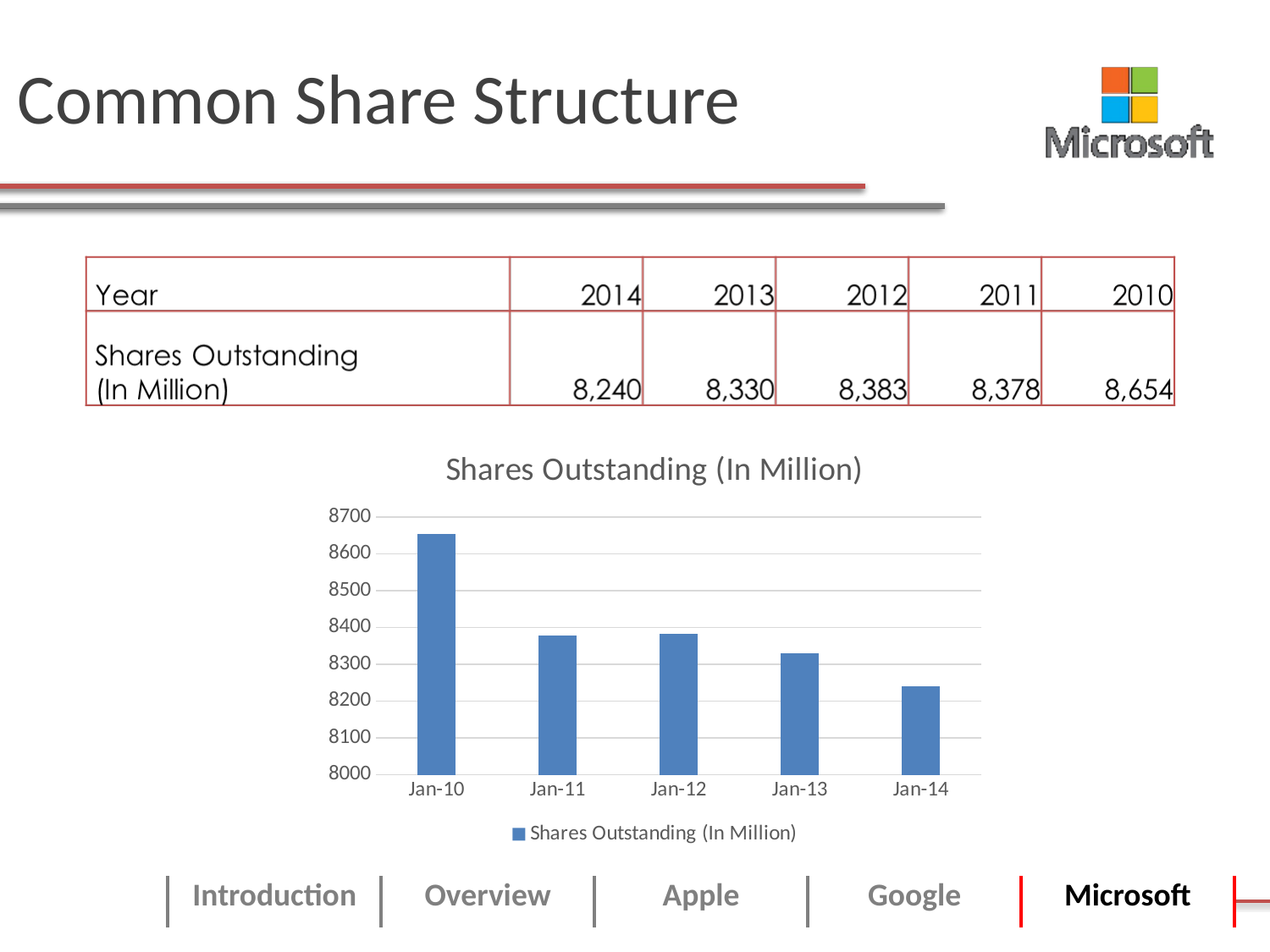
Which time point has the highest shares outstanding in the chart? Jan-10 What is the title of the chart? Shares Outstanding (In Million) What type of chart is shown on the slide? bar chart Is the value for Jan-10 greater or less than 8600? greater Do the shares outstanding generally rise or fall from Jan-10 to Jan-14? fall Is the value for Jan-13 greater or less than 8400? less How many bars (time points) does the chart show? 5 Which time point has the lowest shares outstanding in the chart? Jan-14 Which is larger, the value for Jan-10 or the value for Jan-13? Jan-10 Is the value for Jan-14 greater or less than 8300? less According to the table on the slide, what were the shares outstanding (in million) in 2014? 8,240 How many series does the chart legend list? 1